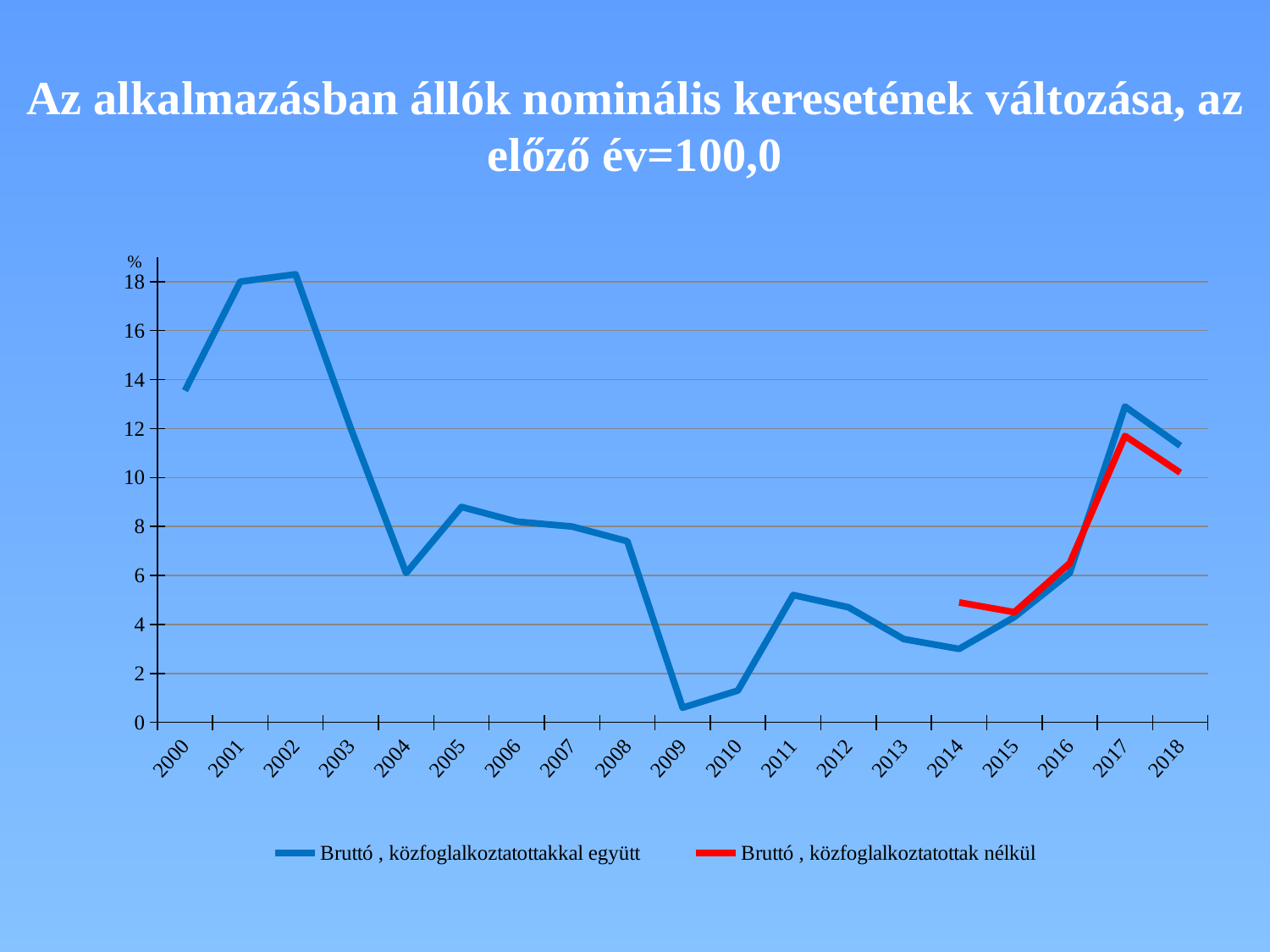
How many years are shown on the x axis? 19 Is the value for 2000 in the 'Bruttó, közfoglalkoztatottakkal együtt' series greater or less than 12? greater Is the value for 2004 in the 'Bruttó, közfoglalkoztatottakkal együtt' series greater or less than 8? less Is the value for 2009 in the 'Bruttó, közfoglalkoztatottakkal együtt' series greater or less than 2? less How many series does the legend list? 2 What kind of chart is shown on the slide? line chart In which year is the 'Bruttó, közfoglalkoztatottakkal együtt' series at its lowest? 2009 Does the 'Bruttó, közfoglalkoztatottak nélkül' series rise or fall from 2015 to 2017? rise Which colour is used for the 'Bruttó, közfoglalkoztatottak nélkül' series? red Does the 'Bruttó, közfoglalkoztatottakkal együtt' series rise or fall from 2002 to 2004? fall In 2018, which series has the higher value: 'Bruttó, közfoglalkoztatottakkal együtt' or 'Bruttó, közfoglalkoztatottak nélkül'? Bruttó, közfoglalkoztatottakkal együtt